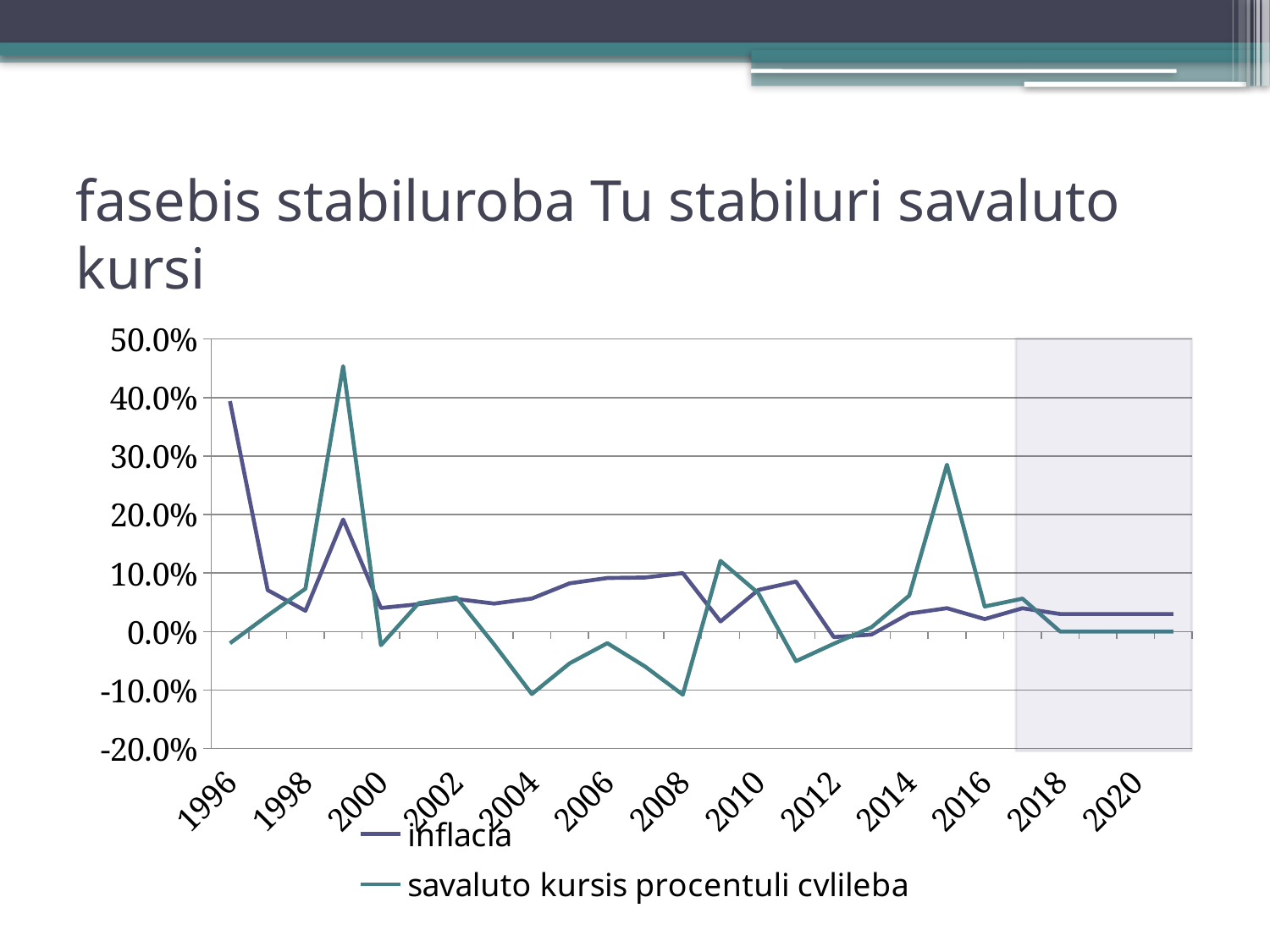
In 1996, which series has the higher value, inflacia or savaluto kursis procentuli cvlileba? inflacia In 1999, which series has the higher value, inflacia or savaluto kursis procentuli cvlileba? savaluto kursis procentuli cvlileba Does the inflacia series rise or fall from 1996 to 1998? fall In which year does the inflacia series reach its highest value? 1996 Is the value for inflacia in 1996 greater or less than 30.0%? greater Is the value for savaluto kursis procentuli cvlileba in 1999 greater or less than 40.0%? greater Is the value for savaluto kursis procentuli cvlileba in 2015 greater or less than 20.0%? greater In which year does the savaluto kursis procentuli cvlileba series reach its highest value? 1999 What are the two series named in the legend? inflacia; savaluto kursis procentuli cvlileba What kind of chart is shown on the slide? line chart How many series does the legend list? 2